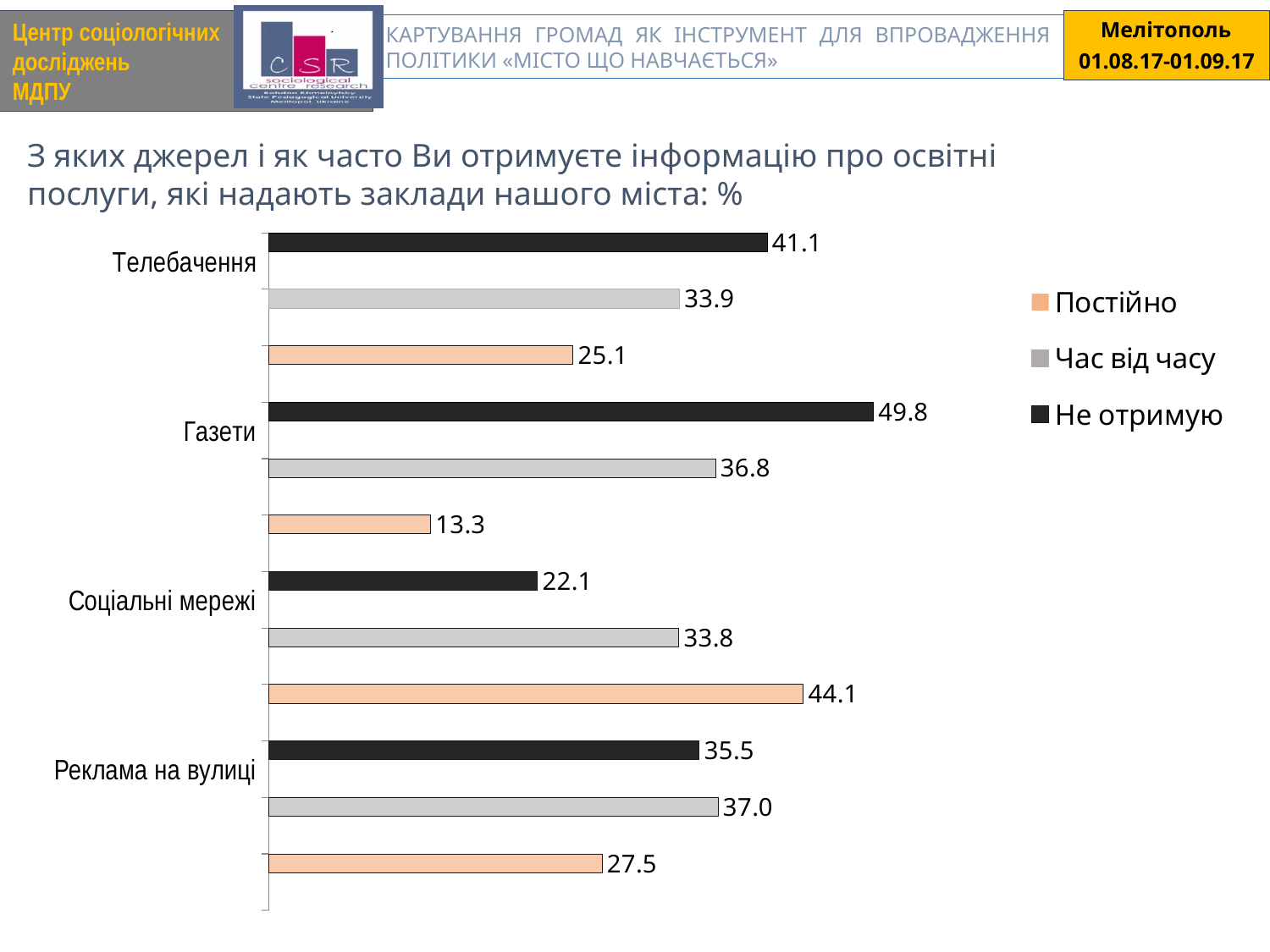
How many categories are shown on the chart? 4 What is the value for "Не отримую" for Газети? 49.8 What kind of chart is shown on the slide? Bar chart Which category has the lowest value for "Постійно"? Газети Which category has the highest value for "Не отримую"? Газети Which is larger for Реклама на вулиці: "Час від часу" or "Не отримую"? Час від часу What is the value for "Постійно" for Соціальні мережі? 44.1 What is the value for "Постійно" for Телебачення? 25.1 What is the difference between the "Не отримую" and "Постійно" values for Газети? 36.5 How many series does the legend list? 3 What is the value for "Час від часу" for Реклама на вулиці? 37.0 Which legend entry is shown in black? Не отримую